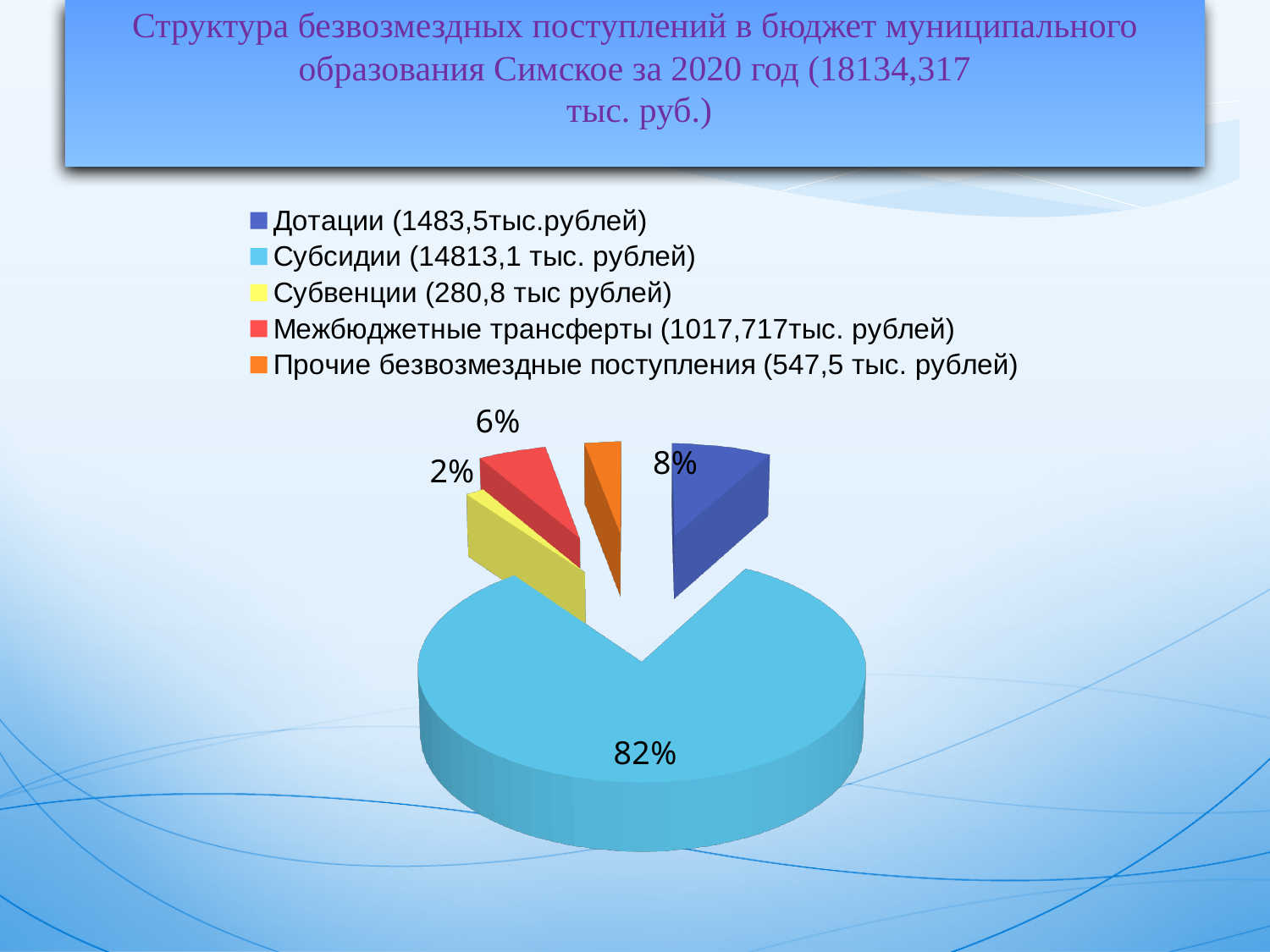
What share of the pie does Субсидии take? 82% Which category has the largest slice of the pie? Субсидии What amount in тыс. рублей does the legend give for Прочие безвозмездные поступления? 547,5 Which is larger, the share for Дотации or the share for Межбюджетные трансферты? Дотации What amount in тыс. рублей does the legend give for Дотации? 1483,5 What share of the pie does Межбюджетные трансферты take? 6% What share of the pie does Дотации take? 8% What kind of chart is shown on the slide? pie chart What is the difference in percentage points between the Субсидии slice and the Дотации slice? 74 How many categories does the legend of the pie chart list? 5 Which category has the smallest slice of the pie? Субвенции